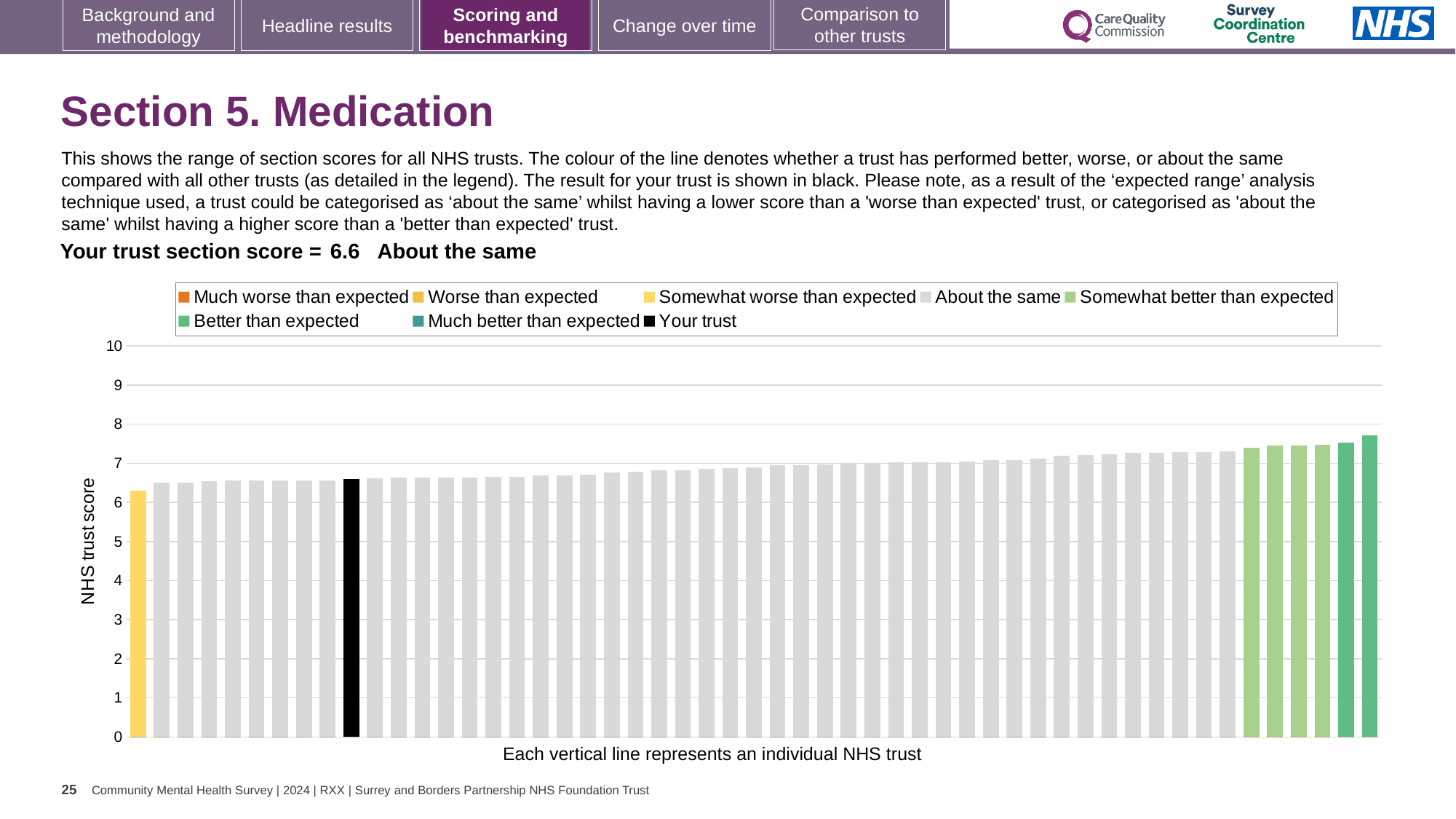
What kind of chart is shown on the slide? bar chart What is the label on the vertical axis of the chart? NHS trust score Is the value of the leftmost bar greater or less than 6? greater How many entries does the chart legend list? 8 What is the section score for your trust shown on the slide? 6.6 What colour is the bar representing your trust? black How is your trust's section score categorised compared with other trusts? About the same How many bars are coloured as 'Better than expected' (darker green)? 2 Do the bar values rise or fall from left to right along the x axis? rise Is the value of the tallest bar (rightmost) greater or less than 7? greater Is the value of the shortest bar (leftmost, yellow) greater or less than 7? less